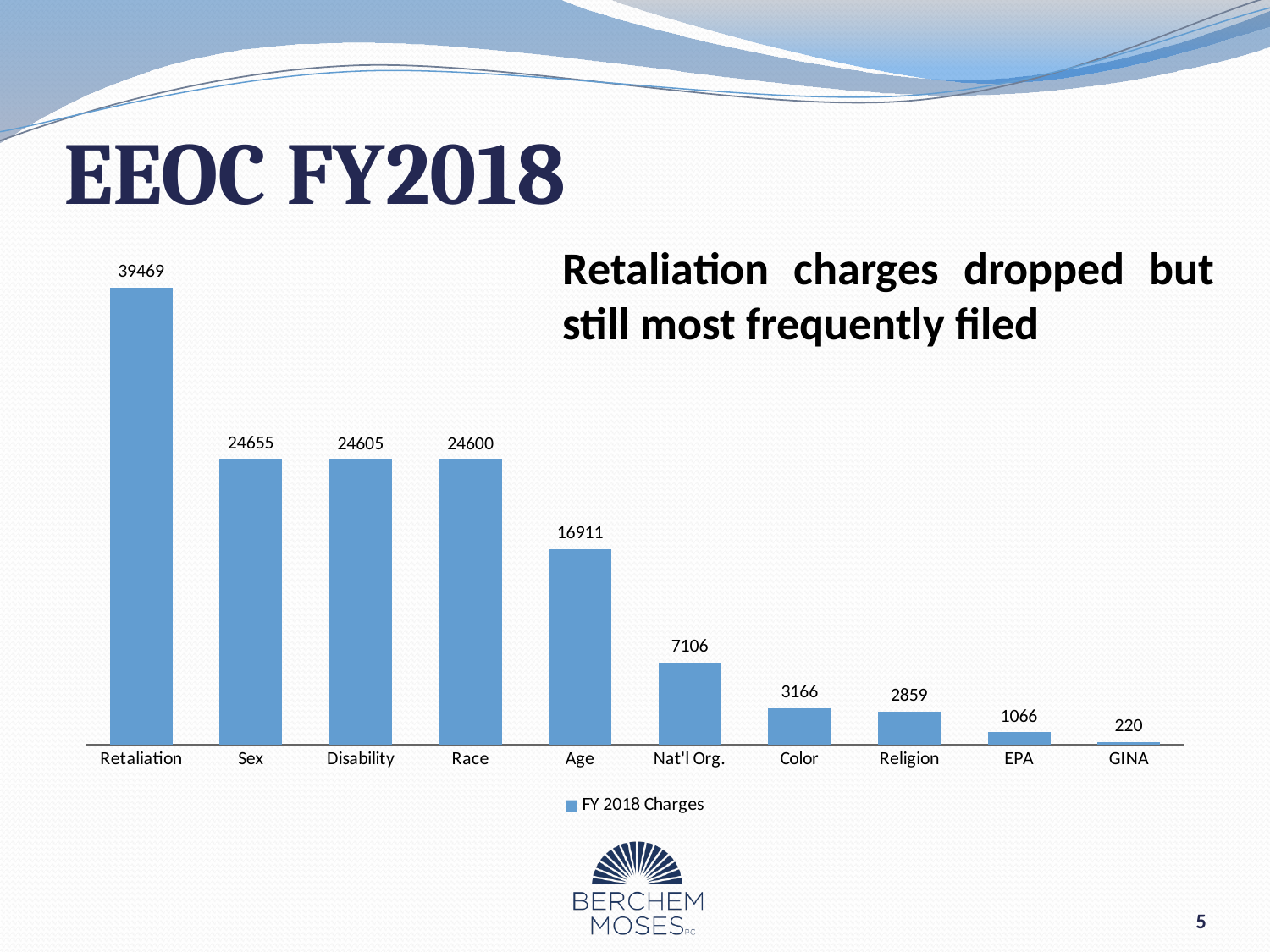
What is the value for Age in the FY 2018 Charges chart? 16911 What is the difference between the Retaliation and Sex values in the FY 2018 Charges chart? 14814 What kind of chart is shown on the slide? Bar chart What is the difference between the Color and Religion values in the FY 2018 Charges chart? 307 What is the value for Retaliation in the FY 2018 Charges chart? 39469 How many categories are shown in the FY 2018 Charges chart? 10 What is the value for GINA in the FY 2018 Charges chart? 220 What series name does the legend of the chart show? FY 2018 Charges Which category has the highest value in the FY 2018 Charges chart? Retaliation What is the value for Nat'l Org. in the FY 2018 Charges chart? 7106 Which category has the lowest value in the FY 2018 Charges chart? GINA Which is larger in the FY 2018 Charges chart, Age or Nat'l Org.? Age